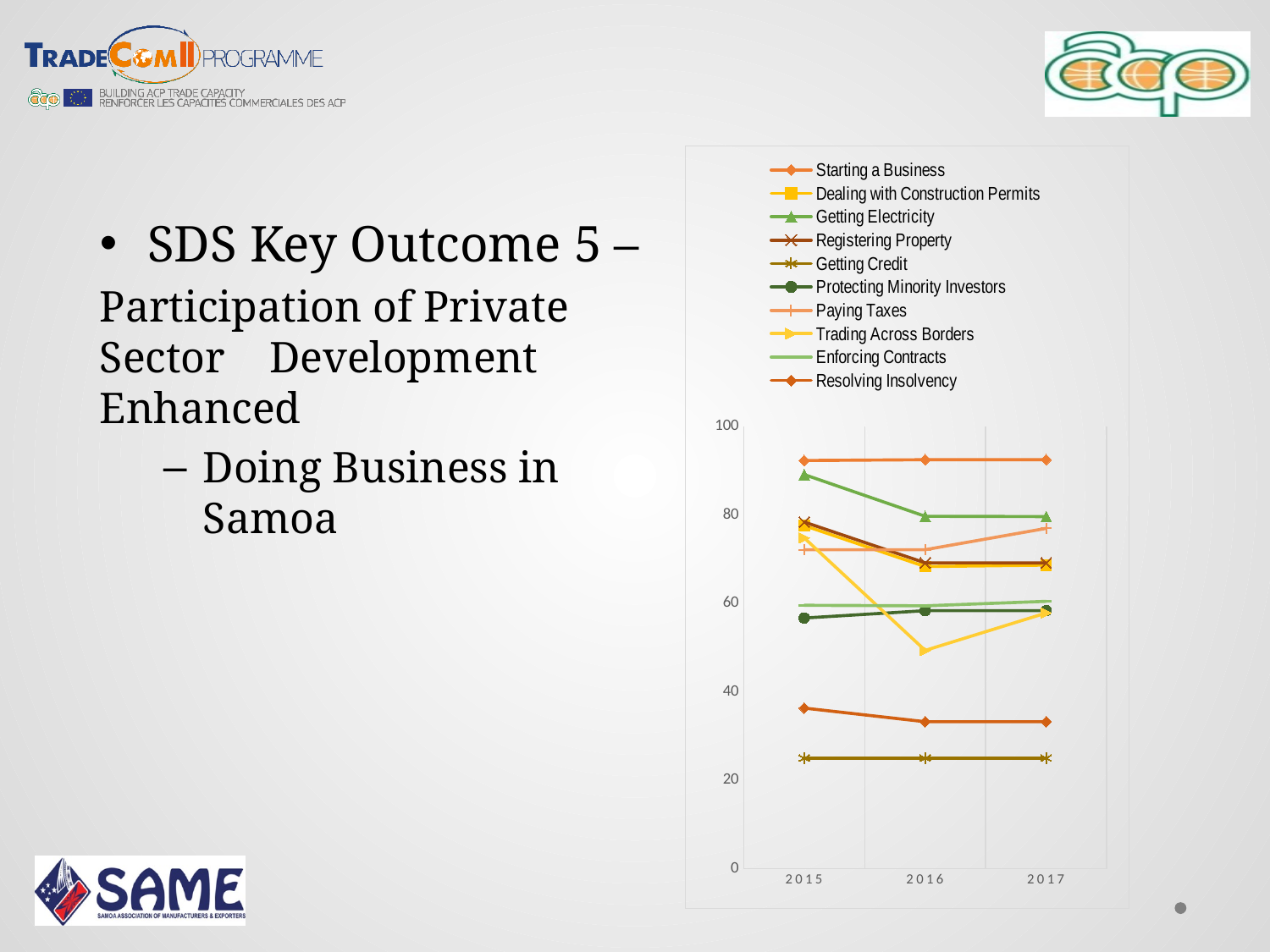
Is the value for Trading Across Borders in 2016 greater or less than 60? less Which series has the highest value in 2017? Starting a Business Does the value for Trading Across Borders rise or fall from 2016 to 2017? rise How many years are shown on the x axis? 3 What is the first series listed in the legend? Starting a Business Which series has the lowest value in 2015? Getting Credit What kind of chart is shown on the slide? line chart Does the value for Getting Electricity rise or fall from 2015 to 2016? fall Is the value for Getting Credit in 2016 greater or less than 40? less Is the value for Starting a Business in 2015 greater or less than 80? greater How many series does the legend list? 10 In 2017, which is larger: Getting Electricity or Resolving Insolvency? Getting Electricity